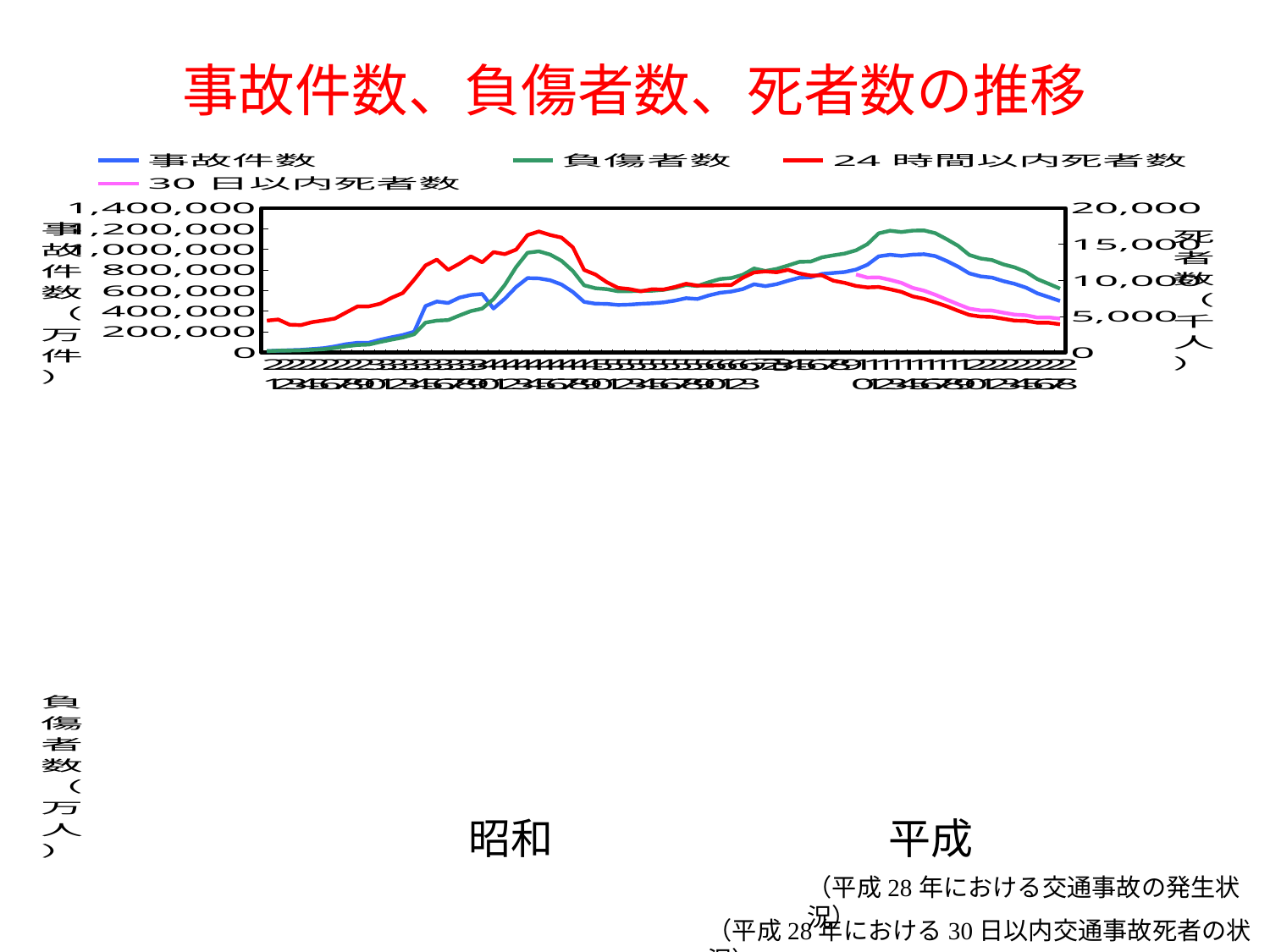
Is the peak value of the 24時間以内死者数 series greater or less than 15,000 on the right axis? greater How many series does the legend list? 4 At the right end of the chart, which series is higher on the left axis: 負傷者数 or 事故件数? 負傷者数 What kind of chart is shown on the slide? line chart What is the maximum value shown on the right vertical axis? 20,000 Does the 24時間以内死者数 series rise or fall over the 平成 period at the right side of the chart? fall Is the peak value of the 負傷者数 series greater or less than 1,000,000 on the left axis? greater Is the peak value of the 事故件数 series greater or less than 1,000,000 on the left axis? less Which colour is used for the 事故件数 series? blue What is the title of the chart? 事故件数、負傷者数、死者数の推移 What is the maximum value shown on the left vertical axis? 1,400,000 Which series has the highest peak on the left axis: 事故件数 or 負傷者数? 負傷者数